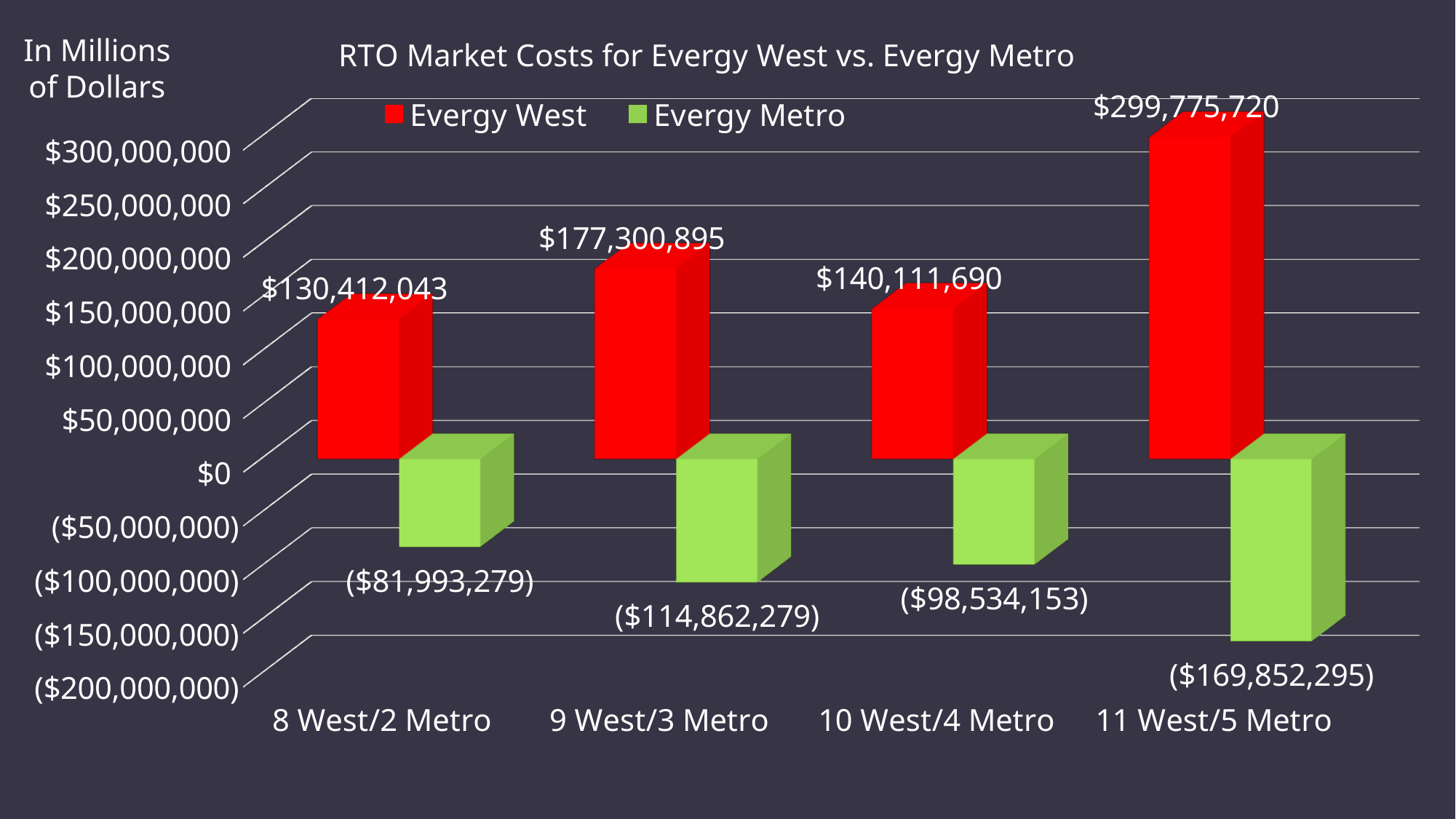
What is the Evergy West value for 11 West/5 Metro? $299,775,720 How many series does the legend list? 2 What is the Evergy Metro value for 9 West/3 Metro? ($114,862,279) Which is larger, the Evergy West value for 9 West/3 Metro or for 10 West/4 Metro? 9 West/3 Metro What is the Evergy Metro value for 10 West/4 Metro? ($98,534,153) How many categories are shown on the x axis? 4 What is the Evergy West value for 8 West/2 Metro? $130,412,043 What kind of chart is shown on the slide? Bar chart What is the title of the chart? RTO Market Costs for Evergy West vs. Evergy Metro What is the difference between the Evergy West values for 9 West/3 Metro and 8 West/2 Metro? $46,888,852 Which category has the highest Evergy West value? 11 West/5 Metro Which category has the lowest Evergy West value? 8 West/2 Metro